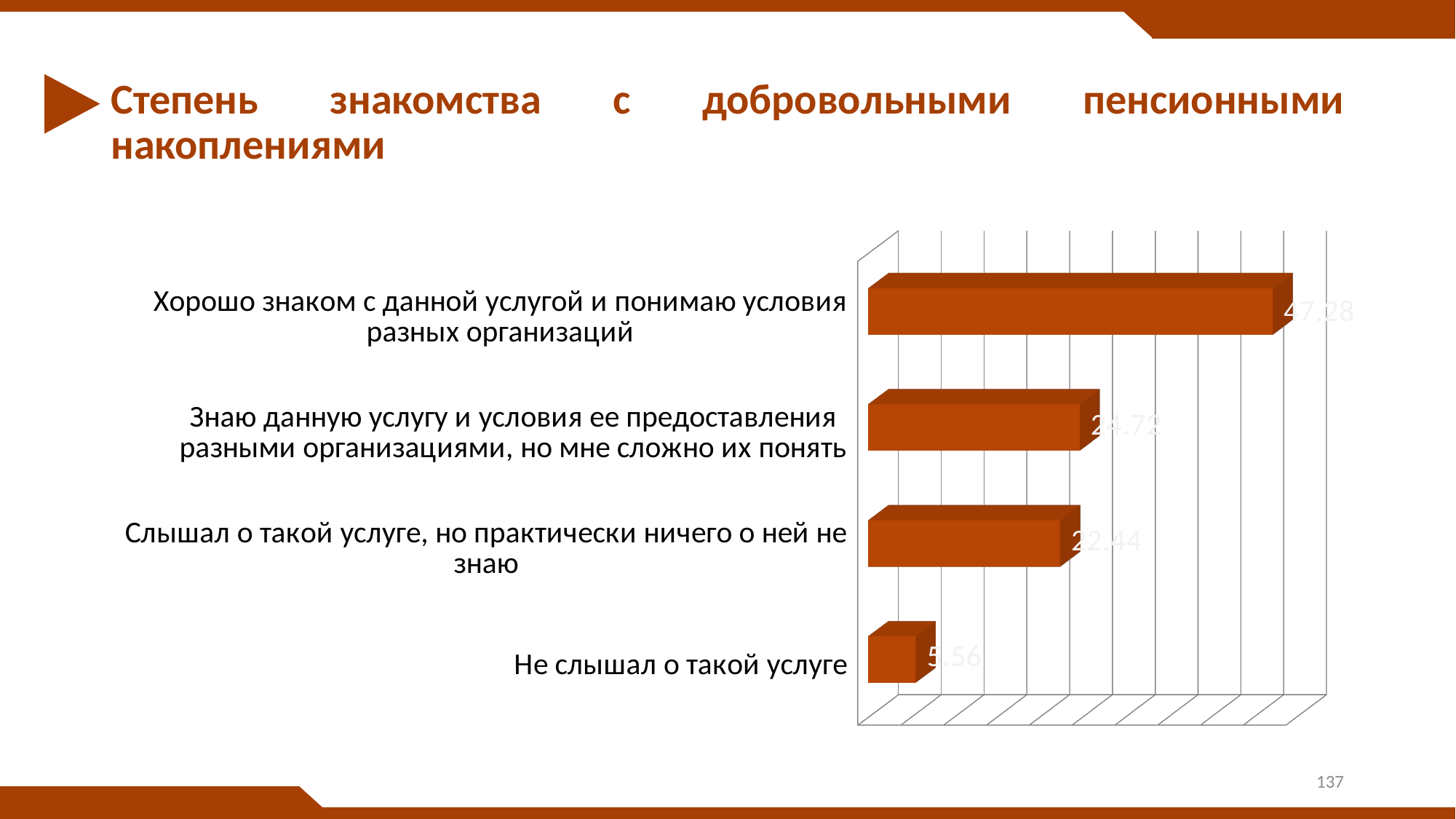
Which category has the lowest value? Не слышал о такой услуге Which is larger: the value for "Слышал о такой услуге, но практически ничего о ней не знаю" or the value for "Не слышал о такой услуге"? Слышал о такой услуге, но практически ничего о ней не знаю What value is shown for "Знаю данную услугу и условия ее предоставления разными организациями, но мне сложно их понять"? 24.72 What kind of chart is shown on the slide? Bar chart How many categories are shown in the chart? 4 What is the title of the slide? Степень знакомства с добровольными пенсионными накоплениями Which category has the highest value? Хорошо знаком с данной услугой и понимаю условия разных организаций What value is shown for "Слышал о такой услуге, но практически ничего о ней не знаю"? 22.44 What value is shown for "Хорошо знаком с данной услугой и понимаю условия разных организаций"? 47.28 What is the difference between the values for "Хорошо знаком с данной услугой и понимаю условия разных организаций" and "Не слышал о такой услуге"? 41.72 What is the difference between the values for "Знаю данную услугу и условия ее предоставления разными организациями, но мне сложно их понять" and "Слышал о такой услуге, но практически ничего о ней не знаю"? 2.28 What value is shown for "Не слышал о такой услуге"? 5.56